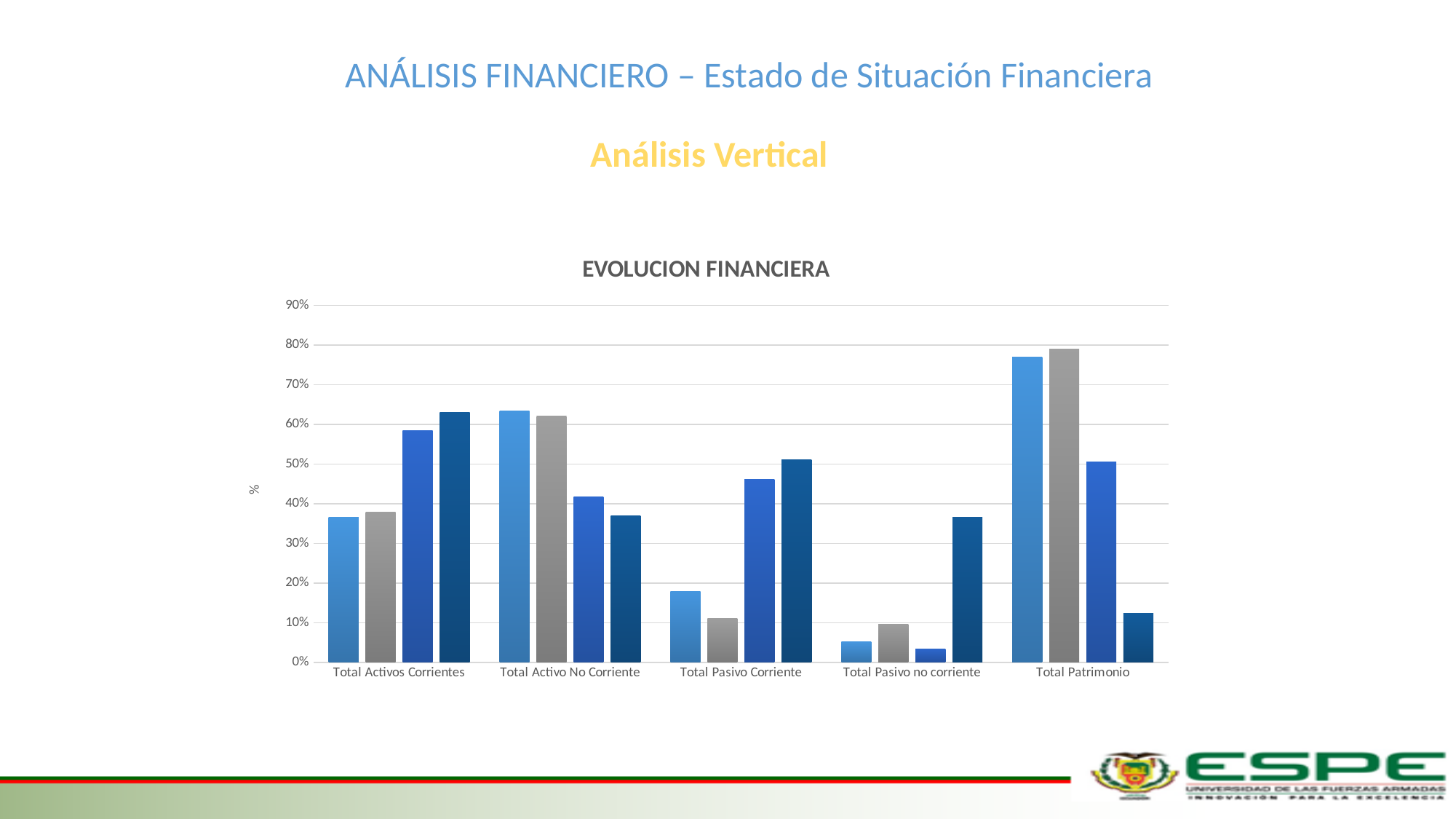
Which category has the tallest bar in the chart? Total Patrimonio Which is larger: the second (gray) bar for Total Activo No Corriente or the second (gray) bar for Total Pasivo Corriente? Total Activo No Corriente Is the value of the first (light blue) bar for Total Activo No Corriente greater or less than 60%? greater How many categories are shown on the x axis of the chart? 5 What is the title of the chart? EVOLUCION FINANCIERA Is the value of the first (light blue) bar for Total Pasivo no corriente greater or less than 10%? less Which category has the shortest bar in the chart? Total Pasivo no corriente What type of chart is shown on the slide? bar chart Is the value of the second (gray) bar for Total Patrimonio greater or less than 70%? greater Which is larger: the first (light blue) bar for Total Patrimonio or the first (light blue) bar for Total Activos Corrientes? Total Patrimonio How many bars are plotted for each category in the chart? 4